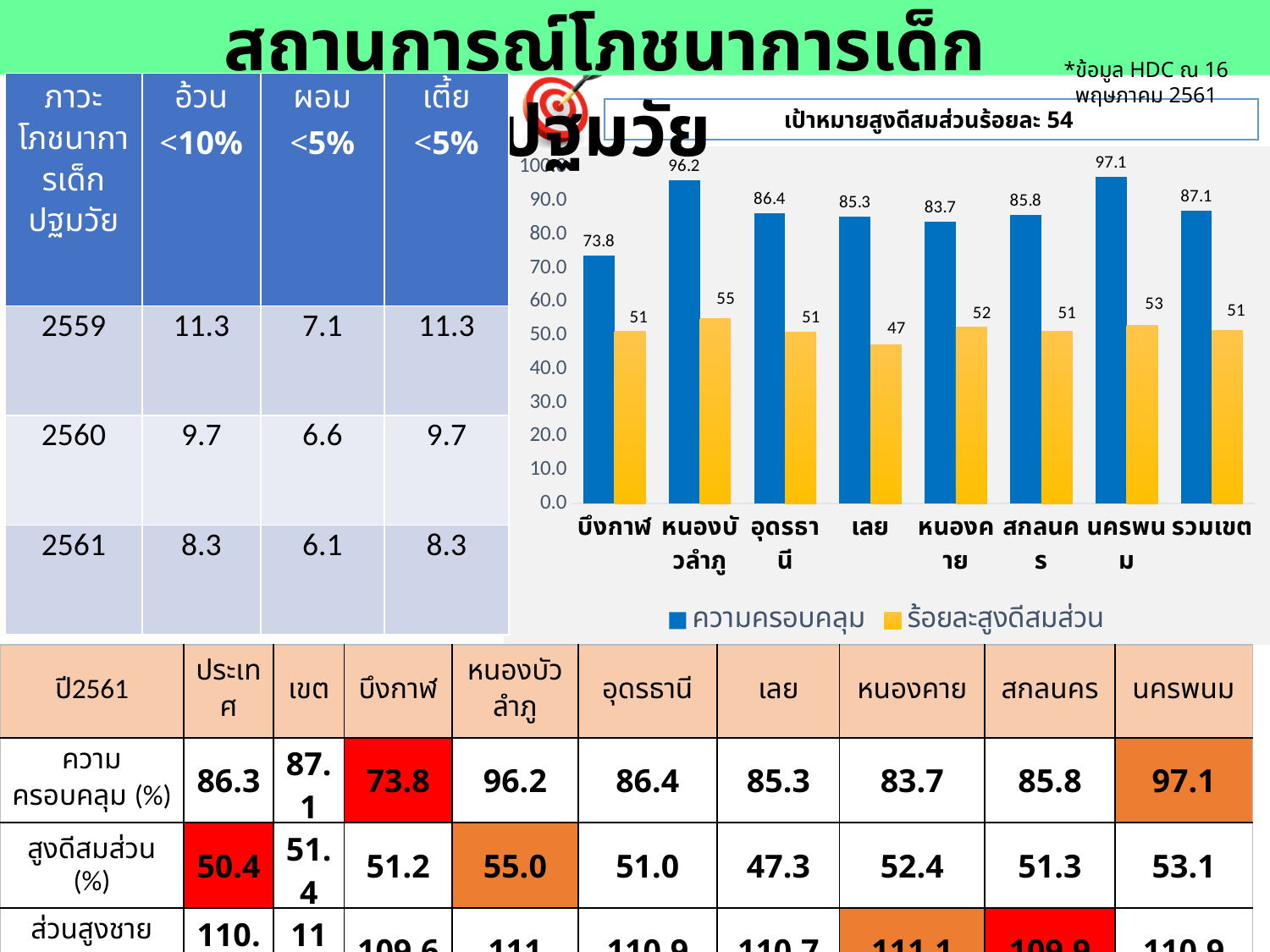
What is the value of ความครอบคลุม for บึงกาฬ? 73.8 Which has a larger ความครอบคลุม value, หนองคาย or สกลนคร? สกลนคร Which category has the lowest ร้อยละสูงดีสมส่วน value? เลย How many categories are shown on the x axis of the chart? 8 What is the value of ความครอบคลุม for รวมเขต? 87.1 What is the difference between the ร้อยละสูงดีสมส่วน values for หนองบัวลำภู and เลย? 8 What is the value of ร้อยละสูงดีสมส่วน for หนองบัวลำภู? 55 How many series does the chart legend list? 2 Is the ความครอบคลุม value for บึงกาฬ greater or less than 80.0? less What is the difference between the ความครอบคลุม values for นครพนม and บึงกาฬ? 23.3 What type of chart is shown on the slide? bar chart Which category has the highest ความครอบคลุม value? นครพนม